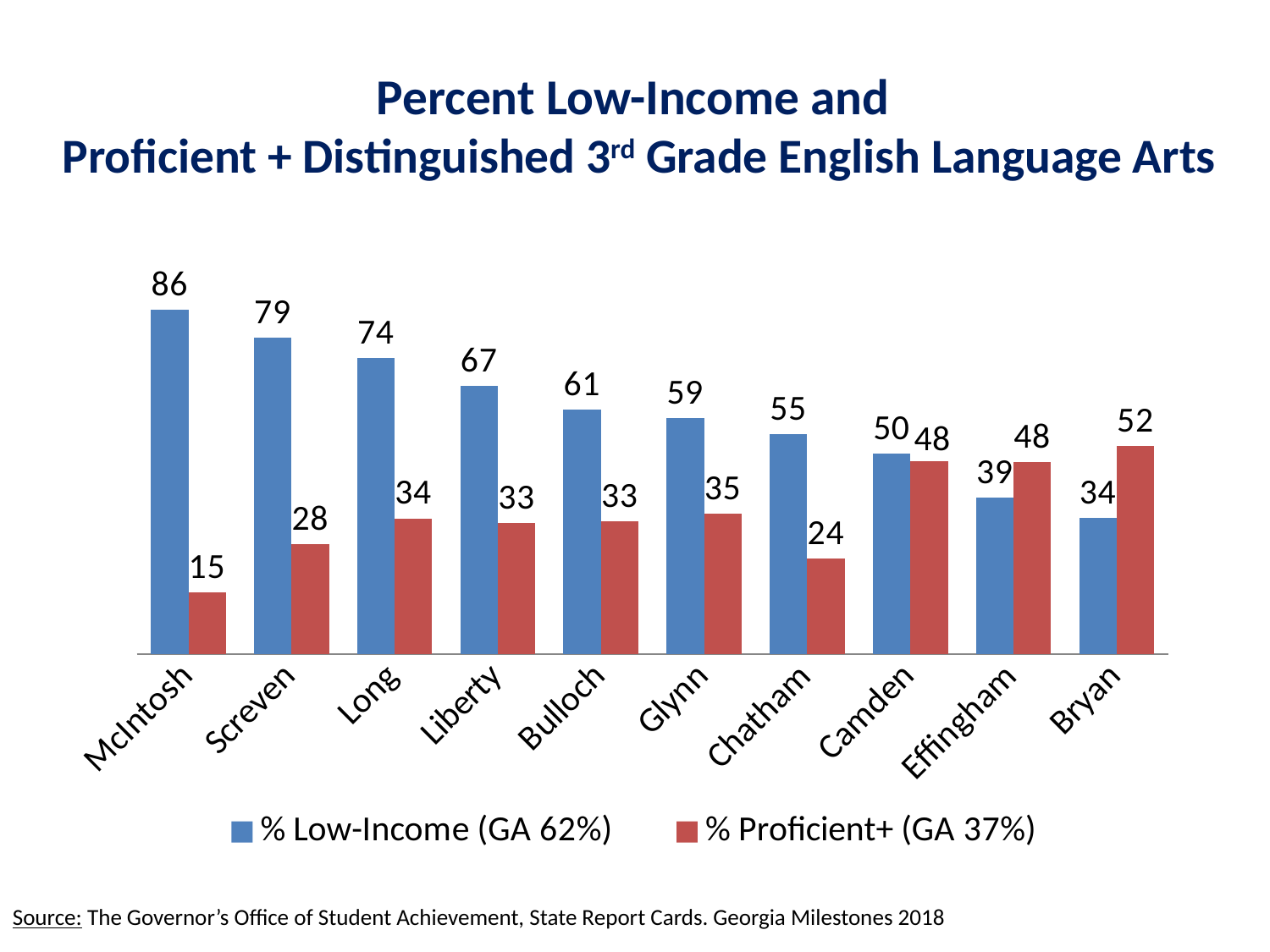
Do the % Low-Income values rise or fall from McIntosh to Bryan? Fall What is the % Low-Income value for McIntosh? 86 Which is larger for Bryan: % Low-Income or % Proficient+? % Proficient+ How many counties are shown on the x axis? 10 What is the difference between the % Low-Income and % Proficient+ values for Screven? 51 What is the % Proficient+ value for Chatham? 24 Which county has the highest % Low-Income value? McIntosh Which county has the lowest % Proficient+ value? McIntosh Which county has the highest % Proficient+ value? Bryan What kind of chart is shown on the slide? Bar chart How many series does the legend list? 2 What Georgia statewide percentage is given in the legend for % Proficient+? 37%